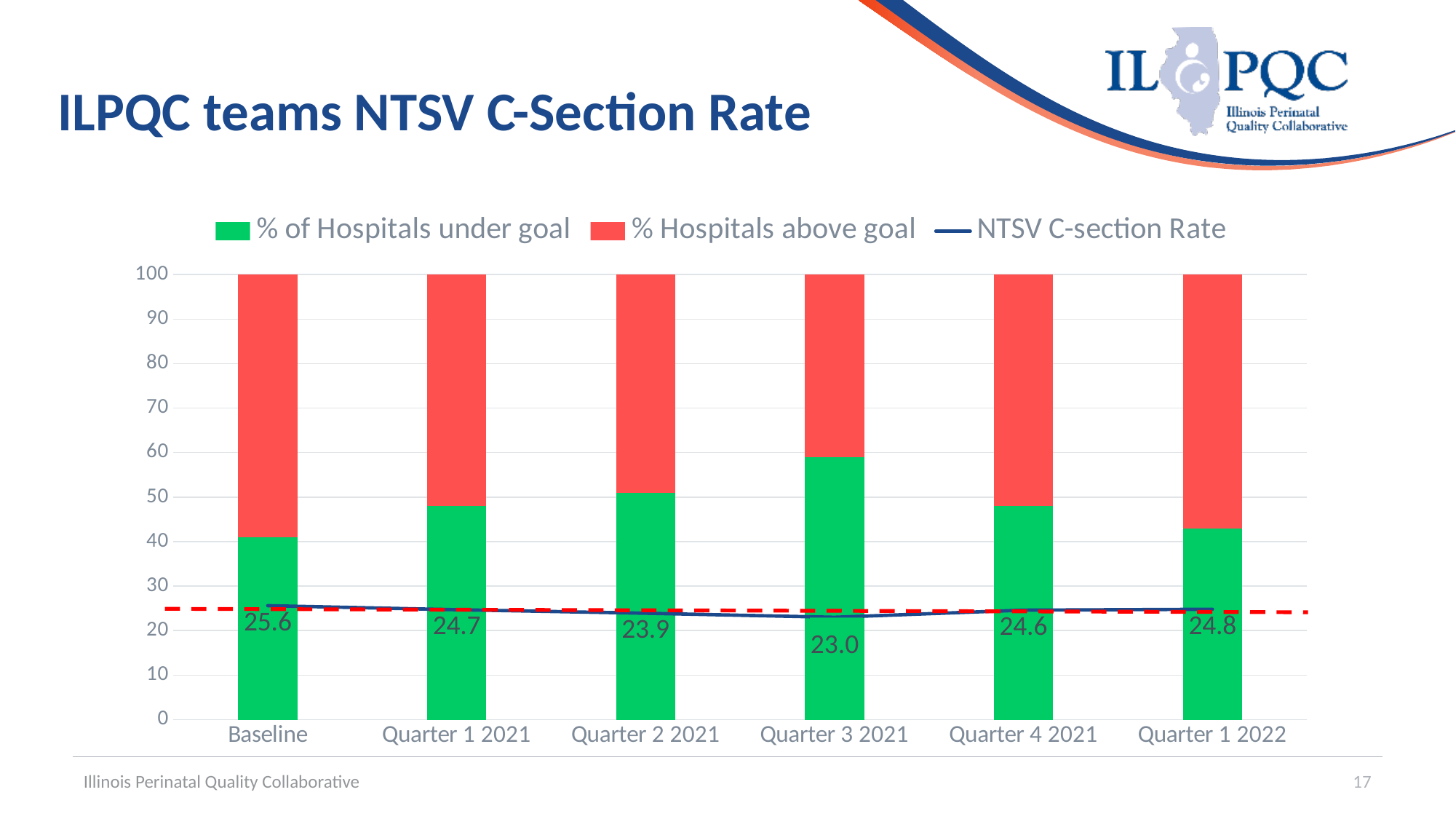
What is the NTSV C-section Rate for Quarter 1 2022? 24.8 Which period has the lowest NTSV C-section Rate? Quarter 3 2021 What is the NTSV C-section Rate at Baseline? 25.6 How many periods are shown on the x axis? 6 Is the value for % of Hospitals under goal at Baseline greater or less than 50? less Which is larger, the NTSV C-section Rate in Quarter 1 2021 or in Quarter 4 2021? Quarter 1 2021 Which period has the highest NTSV C-section Rate? Baseline Is the value for % of Hospitals under goal in Quarter 3 2021 greater or less than 50? greater What is the difference between the NTSV C-section Rate at Baseline and in Quarter 3 2021? 2.6 Which period has the highest % of Hospitals under goal? Quarter 3 2021 What is the NTSV C-section Rate for Quarter 3 2021? 23.0 How many series does the legend list? 3